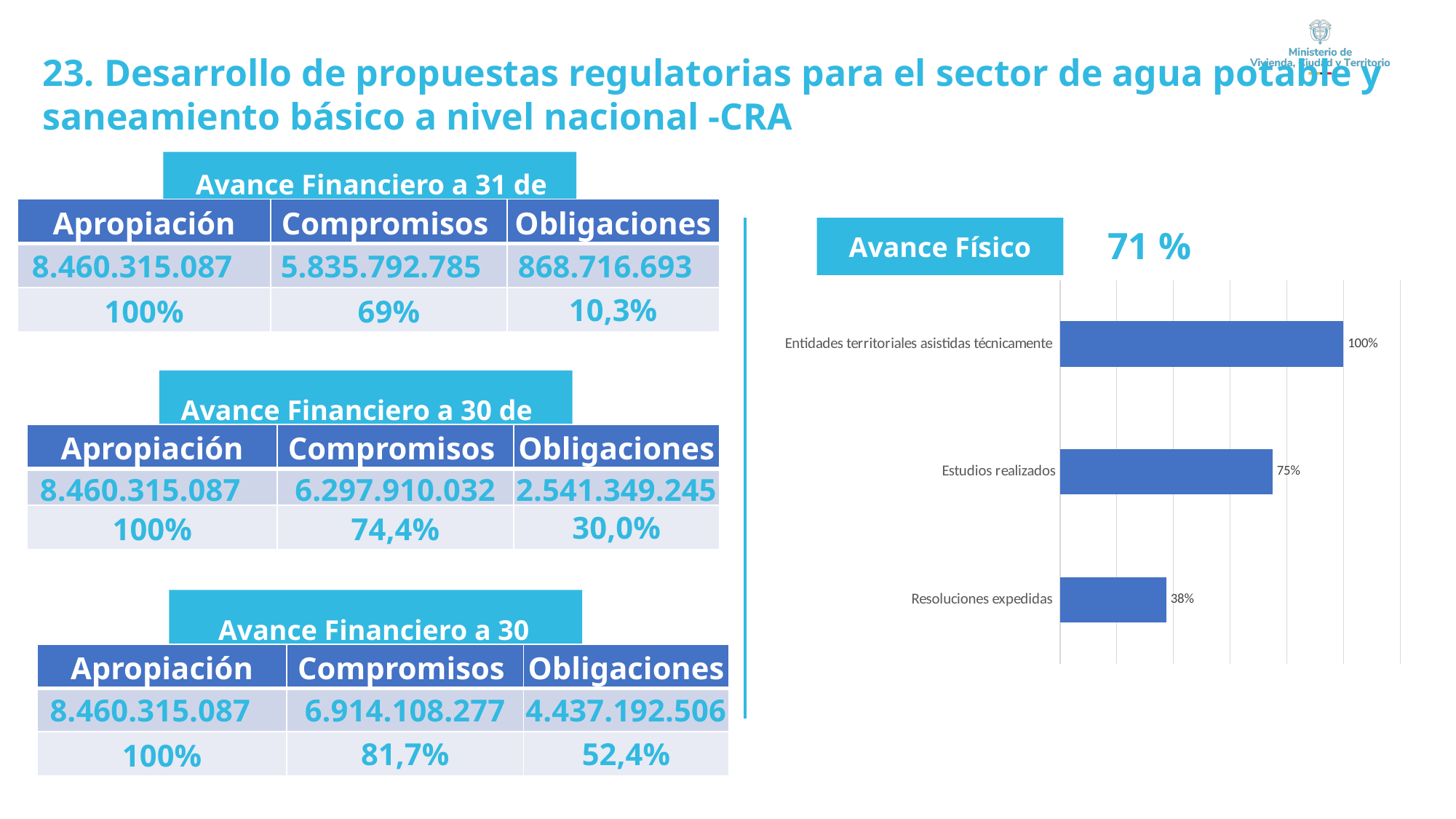
What is the difference between the values for Entidades territoriales asistidas técnicamente and Estudios realizados? 25% What is the value for Entidades territoriales asistidas técnicamente? 100% Which is larger: the value for Estudios realizados or the value for Resoluciones expedidas? Estudios realizados What is the value for Estudios realizados? 75% Which category has the highest value in the bar chart? Entidades territoriales asistidas técnicamente What is the title shown above the bar chart? Avance Físico Which category has the lowest value in the bar chart? Resoluciones expedidas How many categories does the bar chart show? 3 What is the difference between the values for Estudios realizados and Resoluciones expedidas? 37% What type of chart is shown on the slide? bar chart What is the value for Resoluciones expedidas? 38% What overall percentage is displayed next to the chart title Avance Físico? 71 %